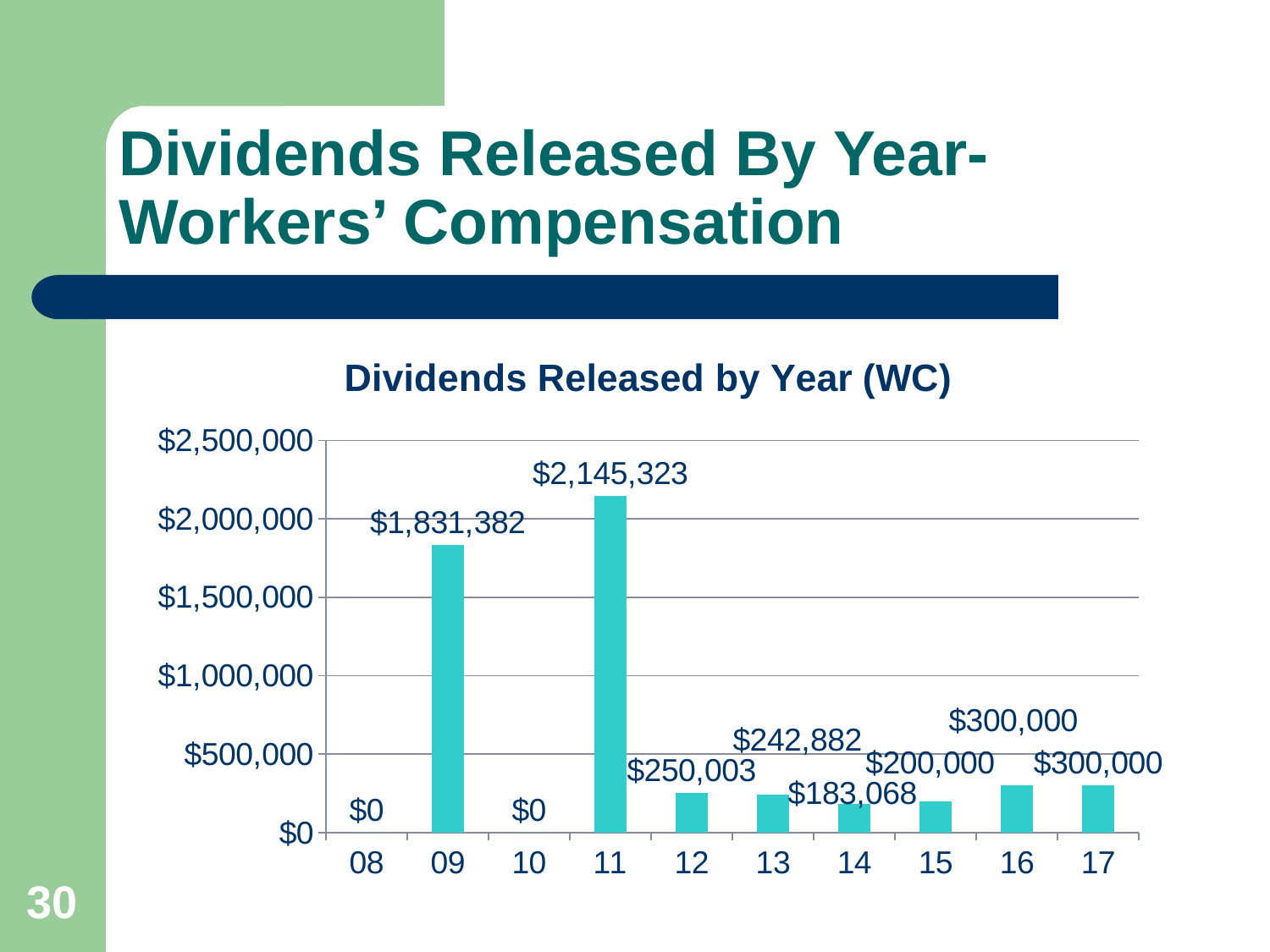
Is the value for year 09 greater or less than $1,500,000? greater How many years are shown on the x axis? 10 What is the dividend released in year 11? $2,145,323 What is the dividend released in year 14? $183,068 What is the difference between the dividends released in year 16 and year 15? $100,000 What kind of chart is this? Bar chart What is the difference between the dividends released in year 11 and year 09? $313,941 How many years show a dividend of $0? 2 Which is larger, the dividend released in year 12 or year 13? 12 Which year has the highest dividend released? 11 What is the dividend released in year 09? $1,831,382 What is the title of the chart? Dividends Released by Year (WC)